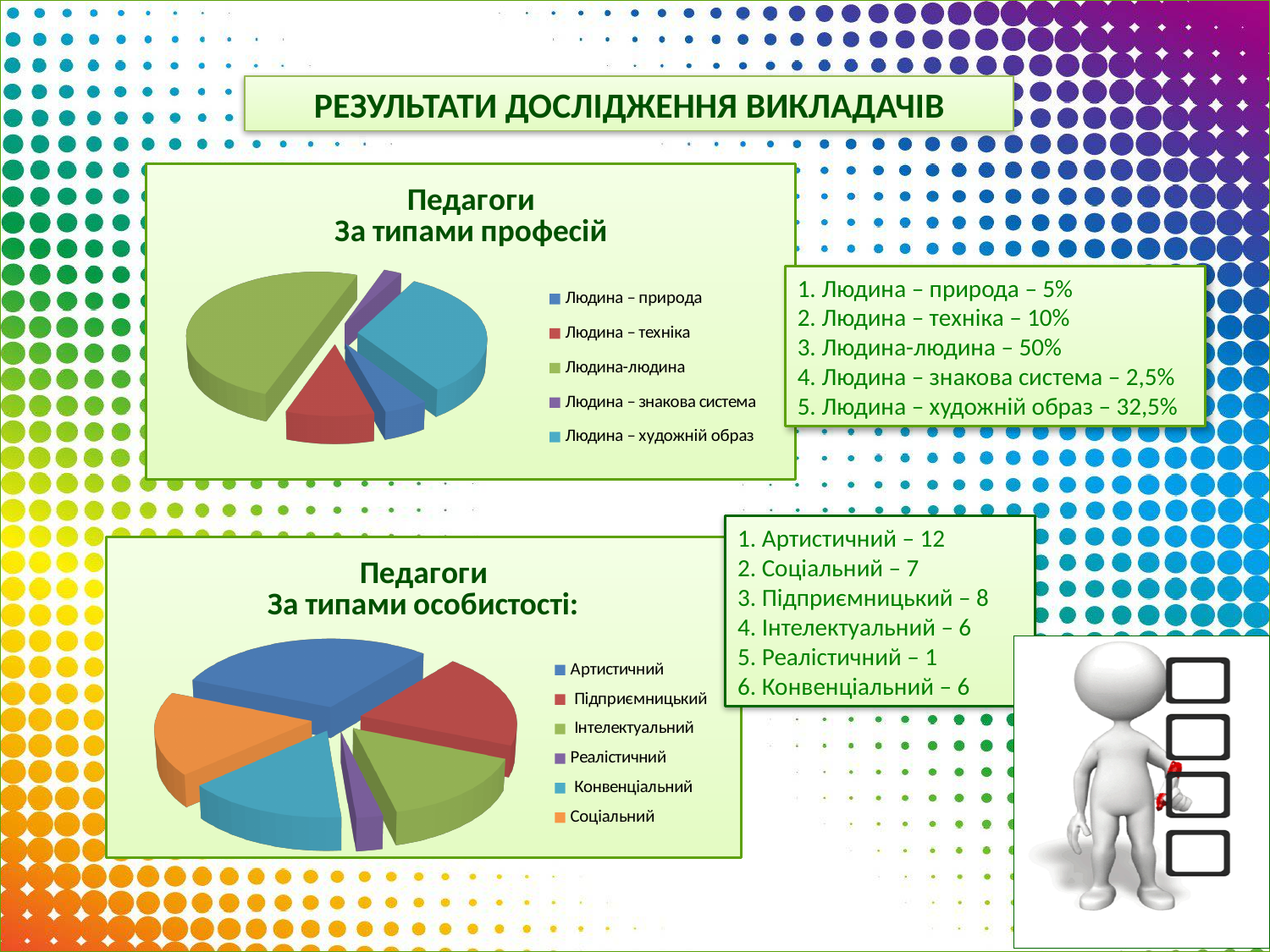
In the 'Педагоги За типами особистості' chart, which is larger: 'Соціальний' or 'Інтелектуальний'? Соціальний In the 'Педагоги За типами особистості' chart, what is the difference between 'Артистичний' and 'Соціальний'? 5 In the 'Педагоги За типами професій' chart, what is the value for 'Людина – художній образ'? 32,5% In the 'Педагоги За типами професій' chart, which category has the smallest share? Людина – знакова система How many categories does the 'Педагоги За типами особистості' pie chart have? 6 In the 'Педагоги За типами особистості' chart, which category has the lowest value? Реалістичний How many categories does the 'Педагоги За типами професій' pie chart have? 5 In the 'Педагоги За типами особистості' chart, what is the value for 'Підприємницький'? 8 In the 'Педагоги За типами професій' chart, which category has the largest share? Людина-людина In the 'Педагоги За типами особистості' chart, which category has the highest value? Артистичний What kind of chart is the 'Педагоги За типами професій' chart? pie chart In the 'Педагоги За типами професій' chart, what is the difference between 'Людина – техніка' and 'Людина – природа'? 5%